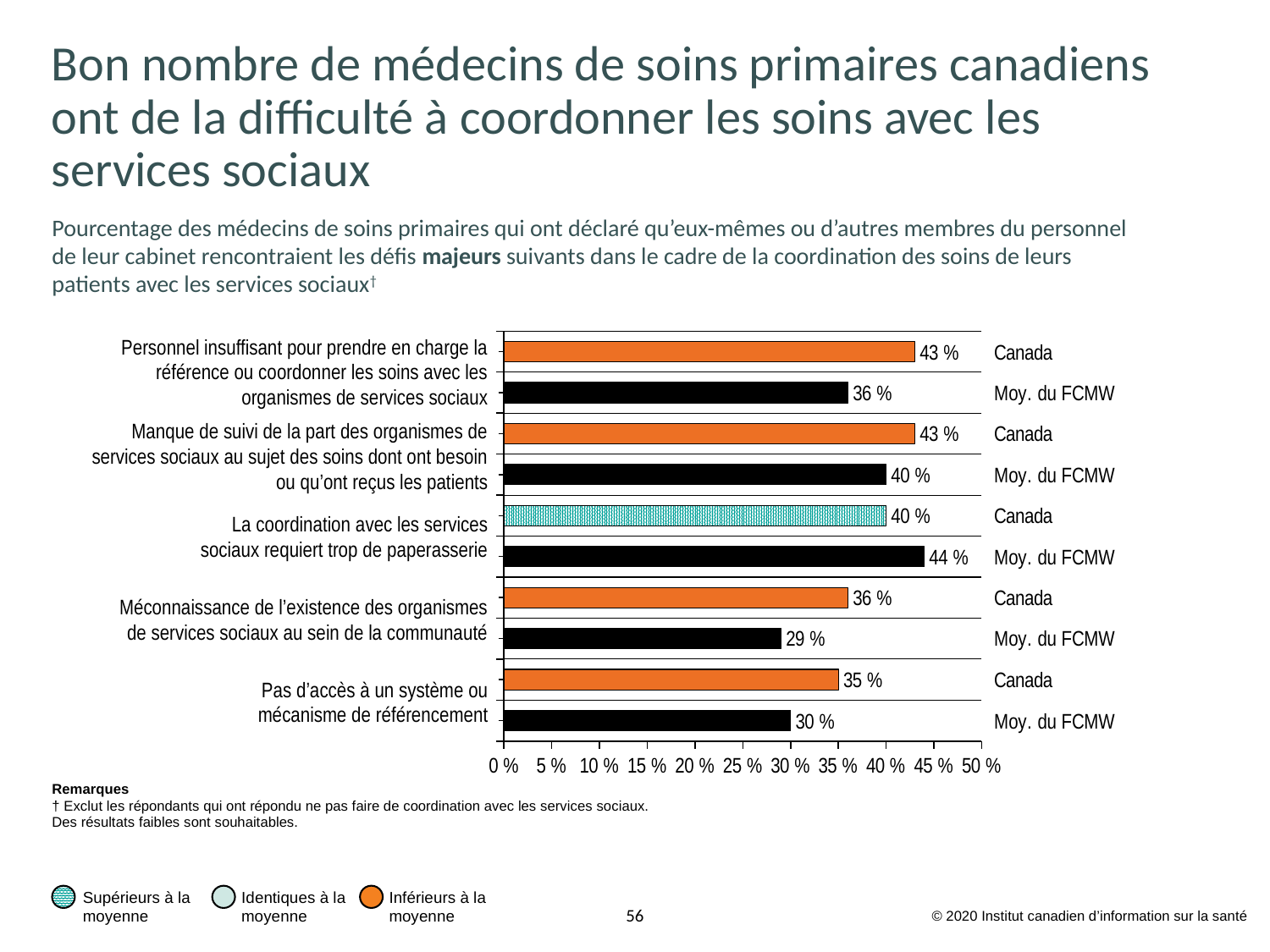
What is the Canada value for "Personnel insuffisant pour prendre en charge la référence ou coordonner les soins avec les organismes de services sociaux"? 43 % What is the difference between the Canada value and the Moy. du FCMW value for "Pas d'accès à un système ou mécanisme de référencement"? 5 % Which category has the highest Moy. du FCMW value? La coordination avec les services sociaux requiert trop de paperasserie What is the Canada value for "Pas d'accès à un système ou mécanisme de référencement"? 35 % Which category has the lowest Moy. du FCMW value? Méconnaissance de l'existence des organismes de services sociaux au sein de la communauté For "La coordination avec les services sociaux requiert trop de paperasserie", which is larger: the Canada value or the Moy. du FCMW value? Moy. du FCMW How many challenge categories are shown on the chart? 5 Is the Canada value for "Pas d'accès à un système ou mécanisme de référencement" greater or less than 30 %? greater What kind of chart is shown on the slide? Bar chart What is the Moy. du FCMW value for "La coordination avec les services sociaux requiert trop de paperasserie"? 44 % What is the Moy. du FCMW value for "Méconnaissance de l'existence des organismes de services sociaux au sein de la communauté"? 29 % What is the difference between the Canada value and the Moy. du FCMW value for "Méconnaissance de l'existence des organismes de services sociaux au sein de la communauté"? 7 %